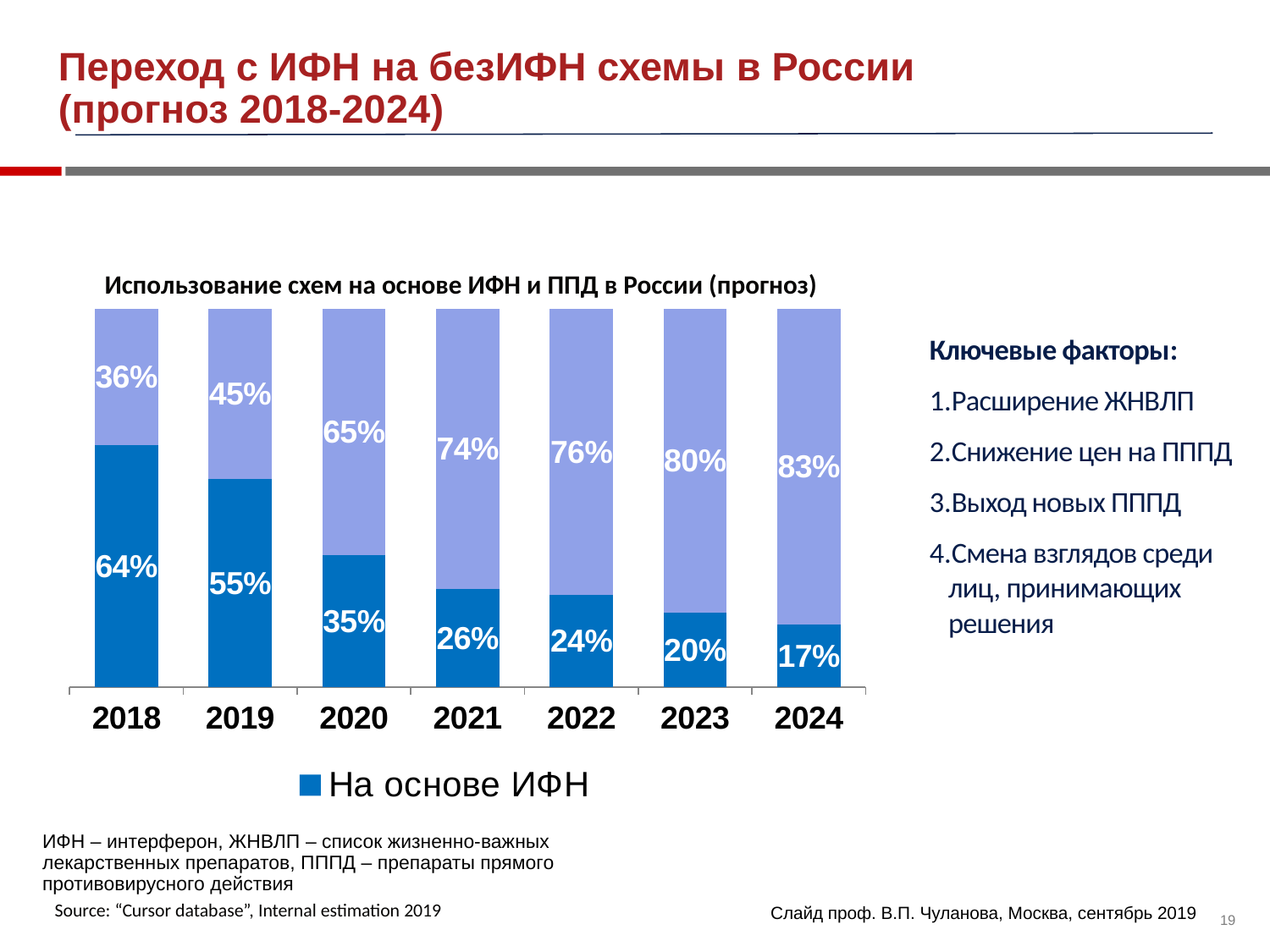
Does the "На основе ИФН" value rise or fall from 2018 to 2024? Fall What is the value for "На основе ИФН" in 2018? 64% Which is larger: the "На основе ИФН" value in 2020 or in 2022? 2020 What is the total of the two segments of the 2023 bar? 100% What is the title of the chart? Использование схем на основе ИФН и ППД в России (прогноз) In which year is the "На основе ИФН" value highest? 2018 How many years are shown on the x axis? 7 In which year is the "На основе ИФН" value lowest? 2024 What kind of chart is shown on the slide? Stacked bar chart What is the value of the upper (light blue) segment in 2021? 74% What is the difference between the "На основе ИФН" values in 2018 and 2019? 9% What is the value for "На основе ИФН" in 2024? 17%